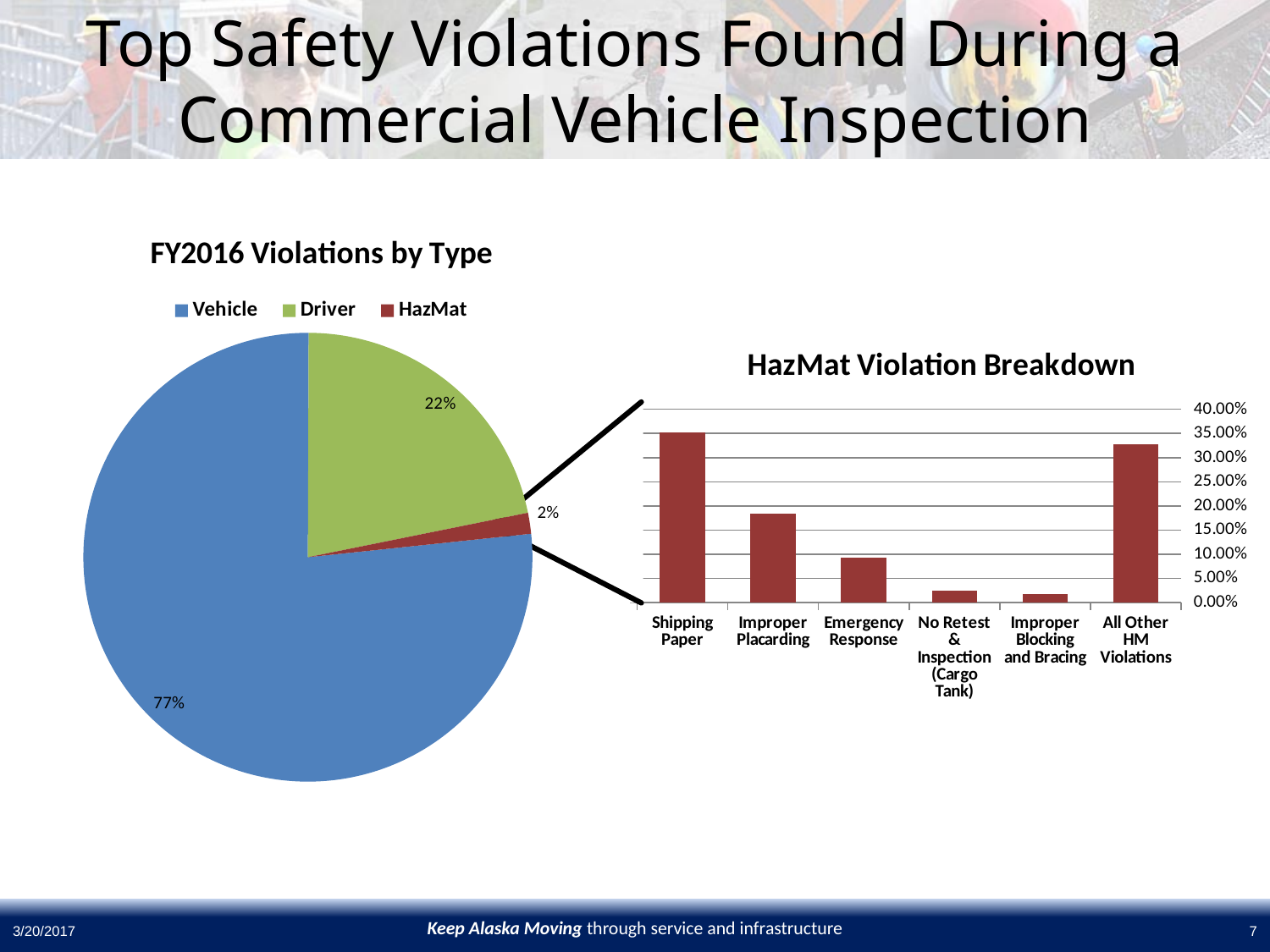
How many categories does the legend of the FY2016 Violations by Type chart list? 3 In the HazMat Violation Breakdown chart, is the value for Emergency Response greater or less than 15.00%? less In the FY2016 Violations by Type pie chart, what share of violations are Driver violations? 22% In the FY2016 Violations by Type pie chart, what percentage is shown for HazMat? 2% In the FY2016 Violations by Type pie chart, which category has the largest share? Vehicle In the FY2016 Violations by Type pie chart, which category has the smallest share? HazMat In the HazMat Violation Breakdown chart, which is larger: Shipping Paper or Improper Placarding? Shipping Paper In the HazMat Violation Breakdown chart, is the value for Shipping Paper greater or less than 30.00%? greater In the FY2016 Violations by Type pie chart, how many percentage points larger is the Vehicle share than the Driver share? 55 How many categories are shown on the x axis of the HazMat Violation Breakdown chart? 6 What kind of chart is the HazMat Violation Breakdown chart? Bar chart In the FY2016 Violations by Type pie chart, what percentage of violations are Vehicle violations? 77%